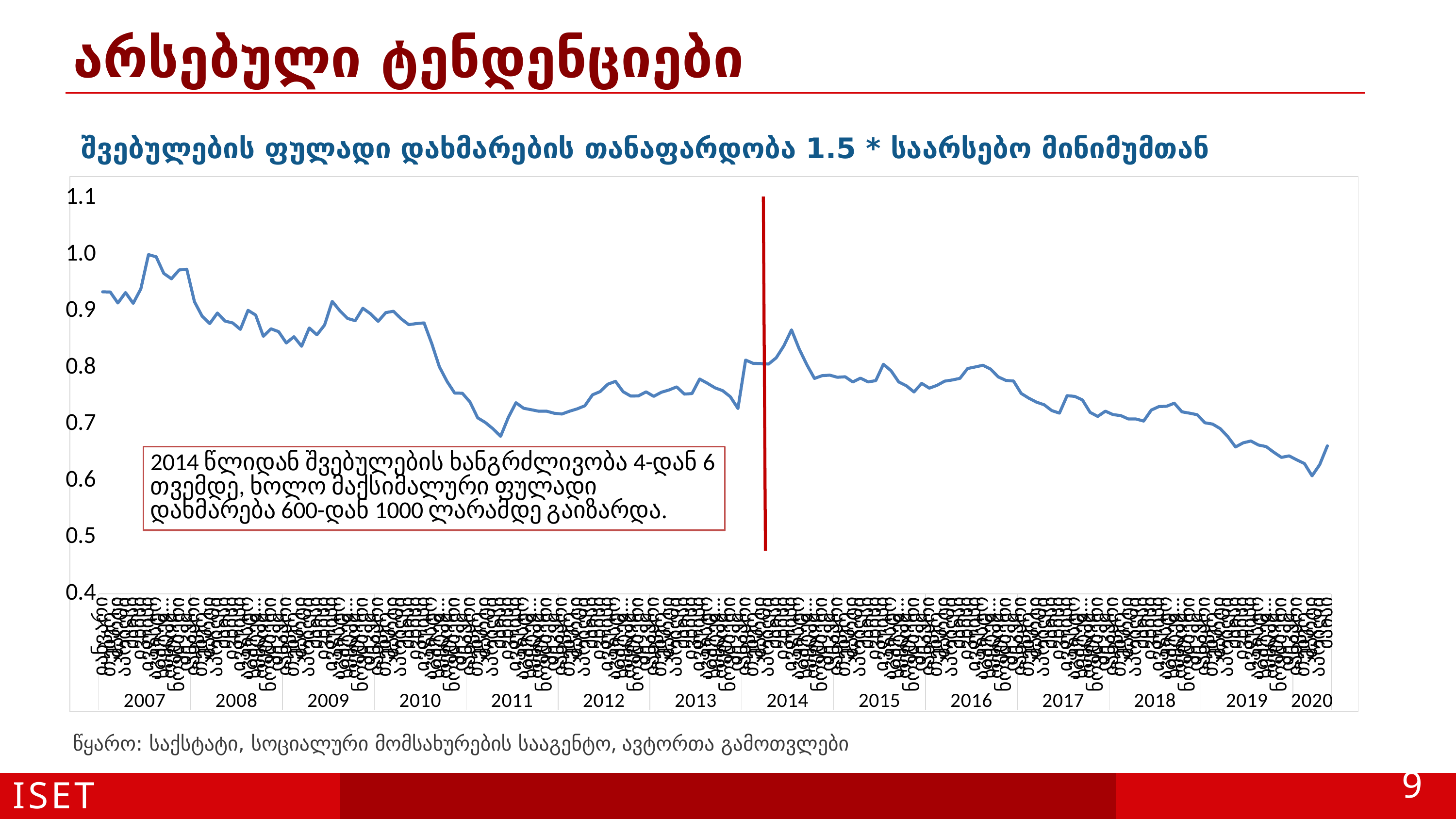
In which year does the line reach its highest value? 2007 Is the value at the start of 2016 greater or less than 0.7? greater Which year is the first labelled on the x axis? 2007 What is the highest value shown on the y axis? 1.1 Is the value at the end of 2019 greater or less than 0.7? less Is the peak value reached in 2007 greater or less than 0.9? greater What kind of chart is shown on the slide? line chart Which is higher, the value at the start of 2007 or the value at the end of 2020? the value at the start of 2007 Overall, does the plotted line rise or fall from 2007 to 2020? fall How many years are labelled along the x axis of the chart? 14 What is the title of the chart? შვებულების ფულადი დახმარების თანაფარდობა 1.5 * საარსებო მინიმუმთან